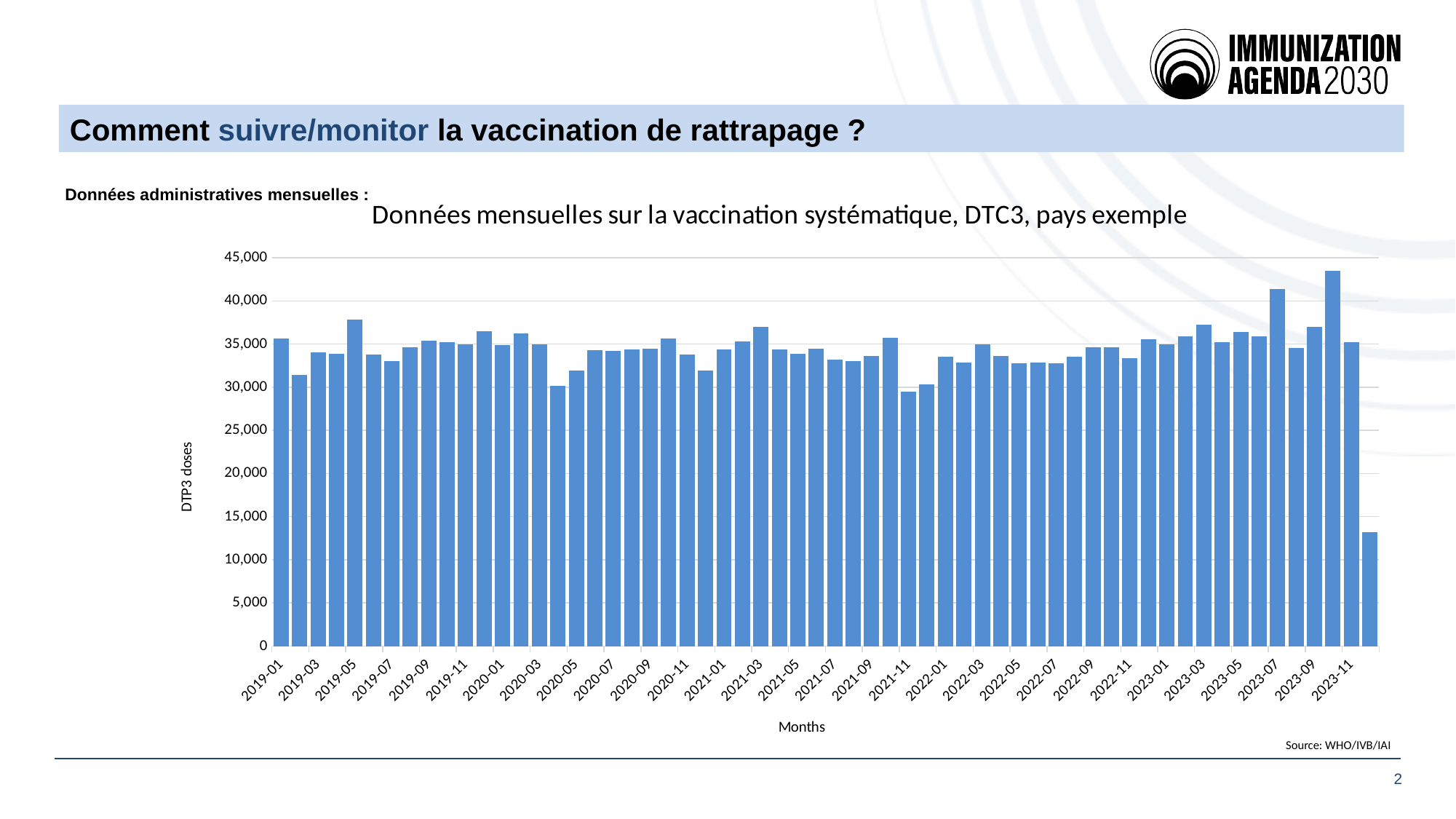
Is the value for 2023-07 greater or less than 40,000? greater Is the value for 2021-11 greater or less than 30,000? less Which month has the larger value, 2021-09 or 2021-11? 2021-09 Is the value for 2019-03 greater or less than 30,000? greater Which month has the larger value, 2023-07 or 2023-09? 2023-07 Which month has the larger value, 2019-05 or 2019-07? 2019-05 In which year does the highest bar of the chart occur? 2023 What kind of chart is shown on the slide? bar chart What is the title of the chart? Données mensuelles sur la vaccination systématique, DTC3, pays exemple What is the label of the vertical axis of the chart? DTP3 doses